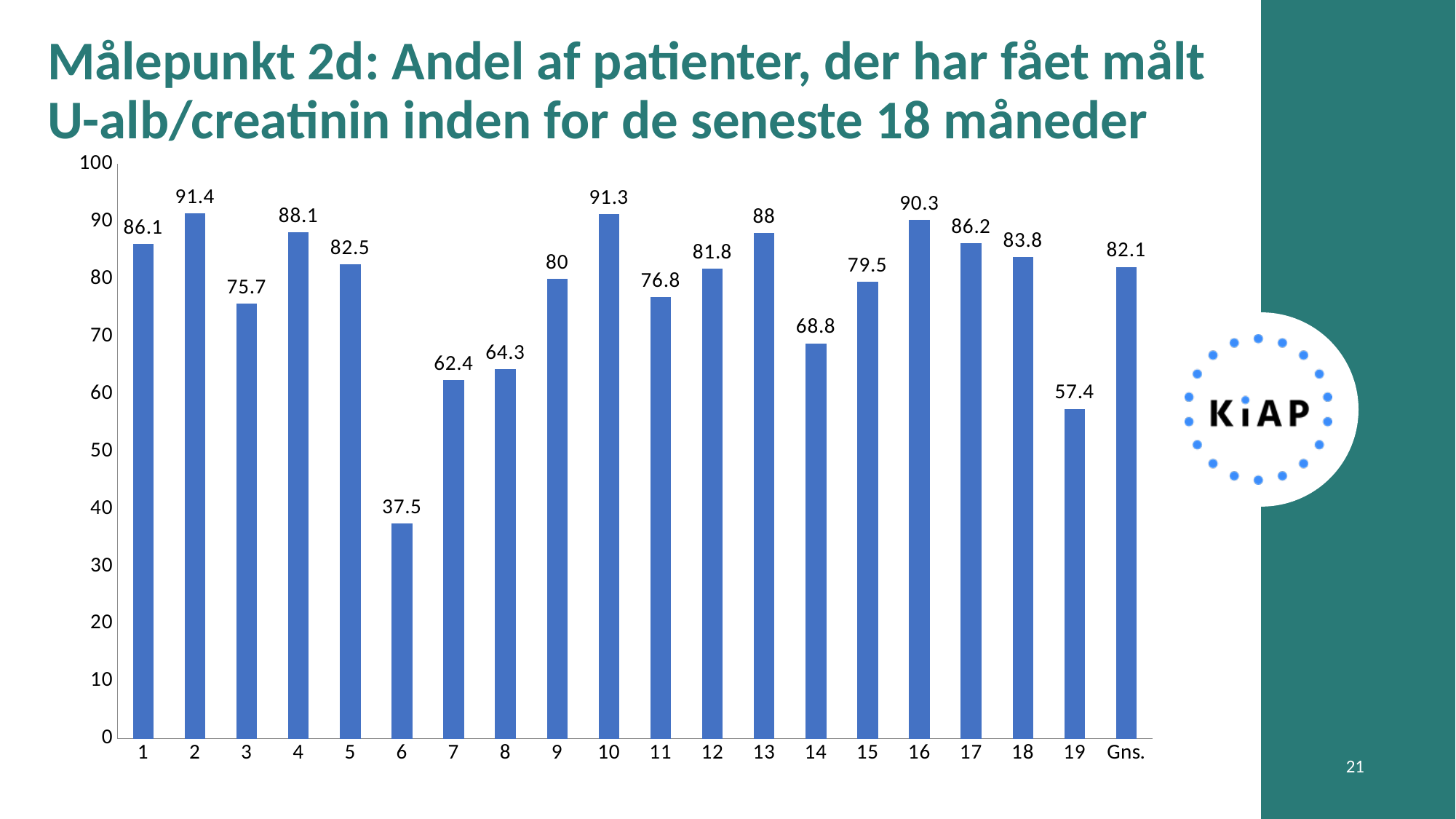
What is the difference between the values for category 2 and category 6? 53.9 What is the value for Gns.? 82.1 Is the value for category 16 greater or less than 80? greater Which category has the lowest value? 6 What kind of chart is shown on the slide? bar chart What is the value for category 19? 57.4 What is the label of the last category on the x axis? Gns. What is the difference between the values for category 9 and category 14? 11.2 Which is larger, the value for category 7 or the value for category 8? 8 How many bars are shown on the chart? 20 What is the value for category 6? 37.5 What is the value for category 13? 88